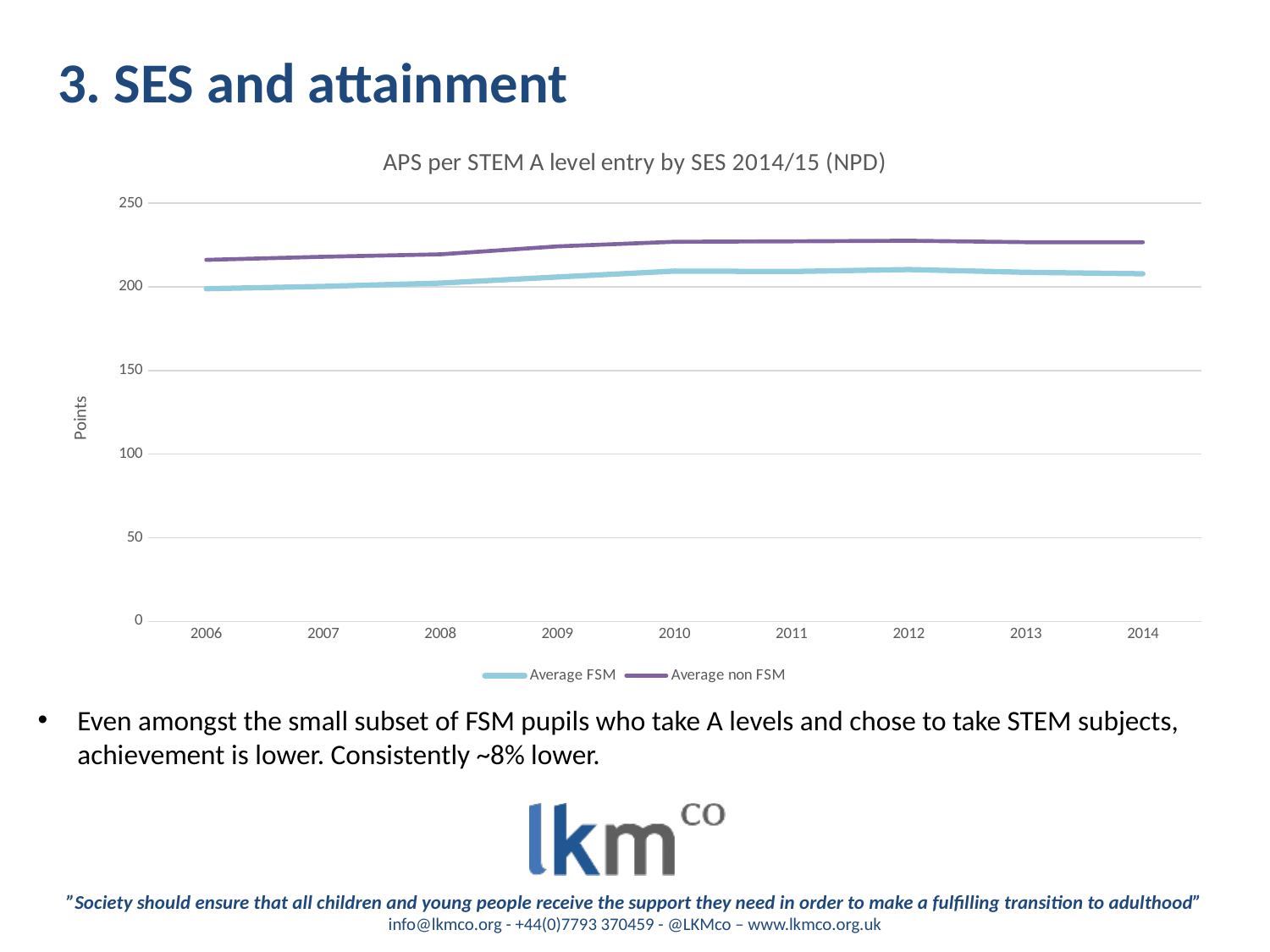
What is the title of the chart? APS per STEM A level entry by SES 2014/15 (NPD) Does the Average FSM line rise or fall between 2006 and 2010? rise Is the value for Average FSM in 2010 greater or less than 200? greater Is the value for Average FSM in 2008 greater or less than 150? greater Is the value for Average non FSM in 2014 greater or less than 250? less What is the label on the y axis? Points What kind of chart is shown on the slide? line chart Which series has the larger value in 2010, Average FSM or Average non FSM? Average non FSM How many years are plotted along the x axis? 9 How many series does the legend list? 2 Which series has the larger value in 2006, Average FSM or Average non FSM? Average non FSM